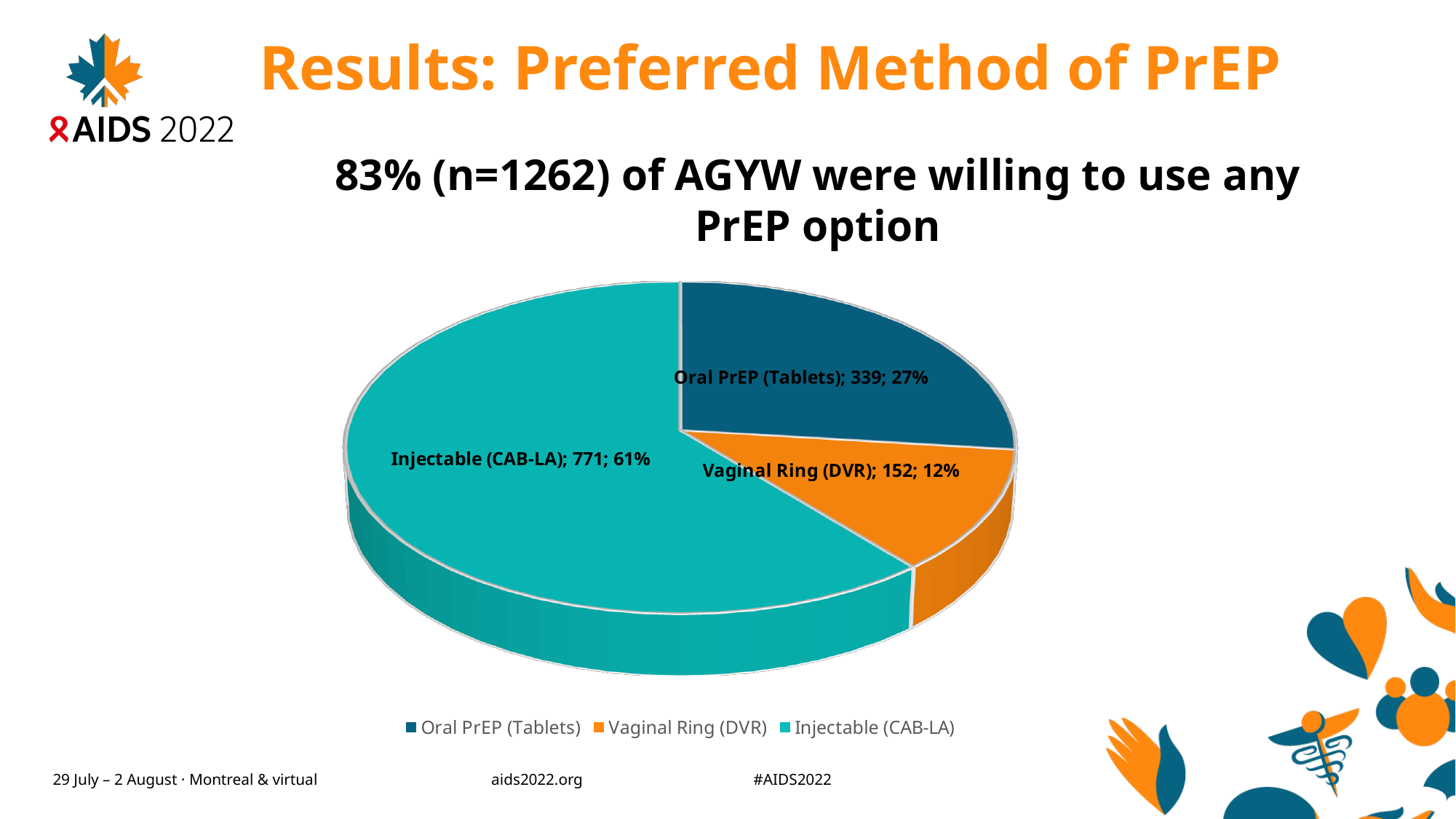
How many AGYW preferred Injectable (CAB-LA)? 771 What is the difference in count between Injectable (CAB-LA) and Oral PrEP (Tablets)? 432 What is the total count across all three slices of the pie? 1262 Which has more respondents, Oral PrEP (Tablets) or Vaginal Ring (DVR)? Oral PrEP (Tablets) What share of the pie does Vaginal Ring (DVR) represent? 12% Which PrEP method has the smallest slice of the pie? Vaginal Ring (DVR) How many categories does the pie chart have? 3 What colour is the Injectable (CAB-LA) slice in the legend? Teal How many AGYW preferred the Vaginal Ring (DVR)? 152 What kind of chart is shown on the slide? Pie chart What percentage of the pie is Oral PrEP (Tablets)? 27% Which PrEP method has the largest slice of the pie? Injectable (CAB-LA)